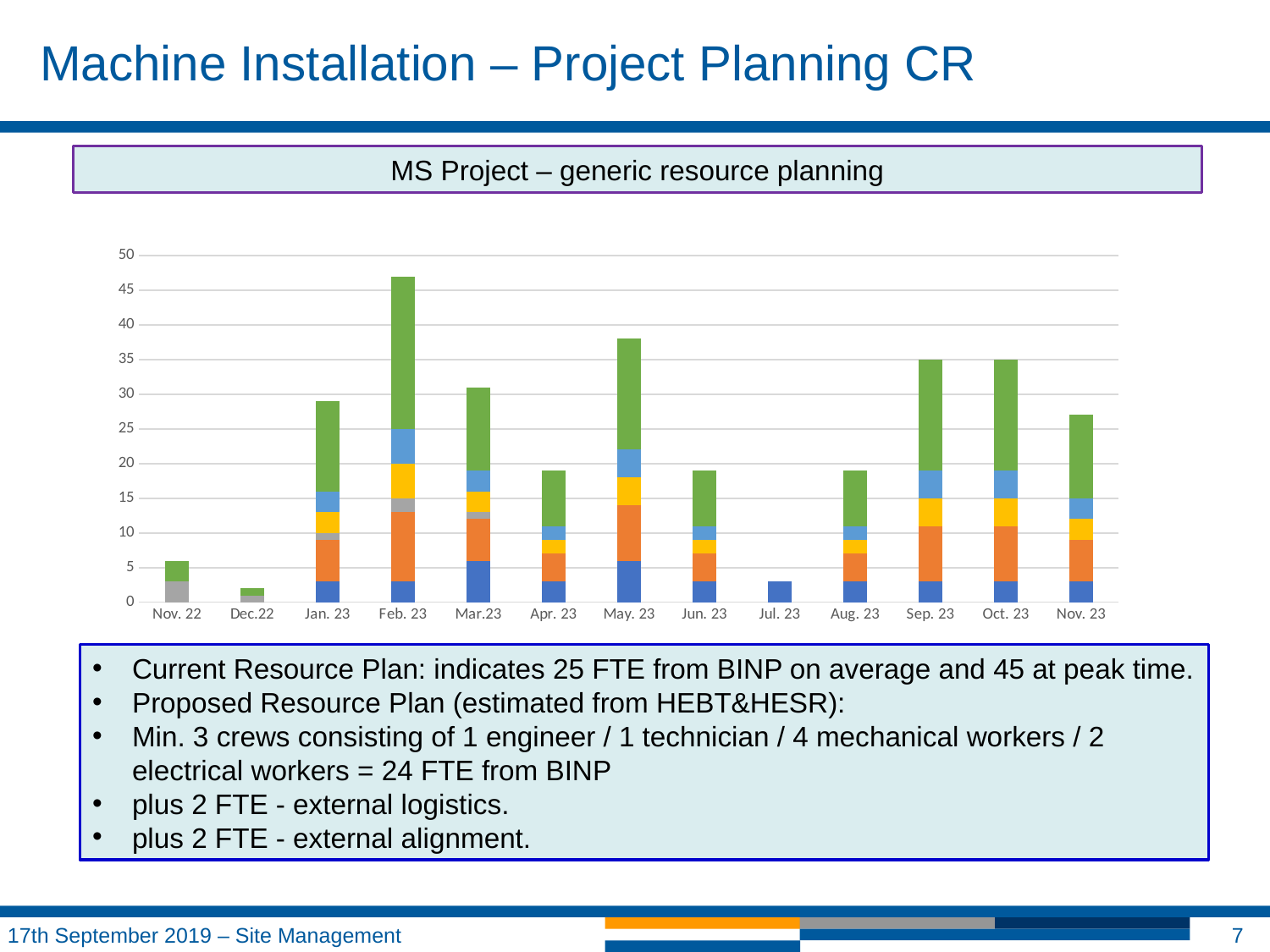
Is the total value for Jan. 23 greater or less than 30? less Do the bar totals rise or fall from Jul. 23 to Oct. 23? rise Which has the taller stacked bar, Mar.23 or Jun. 23? Mar.23 What is the highest value shown on the chart's vertical axis? 50 What kind of chart is shown on the slide? Stacked bar chart Is the total value for Apr. 23 greater or less than 20? less Which has the taller stacked bar, Feb. 23 or May. 23? Feb. 23 Which month has the tallest stacked bar in the chart? Feb. 23 Is the total value for May. 23 greater or less than 35? greater How many months (categories) are shown on the x axis of the chart? 13